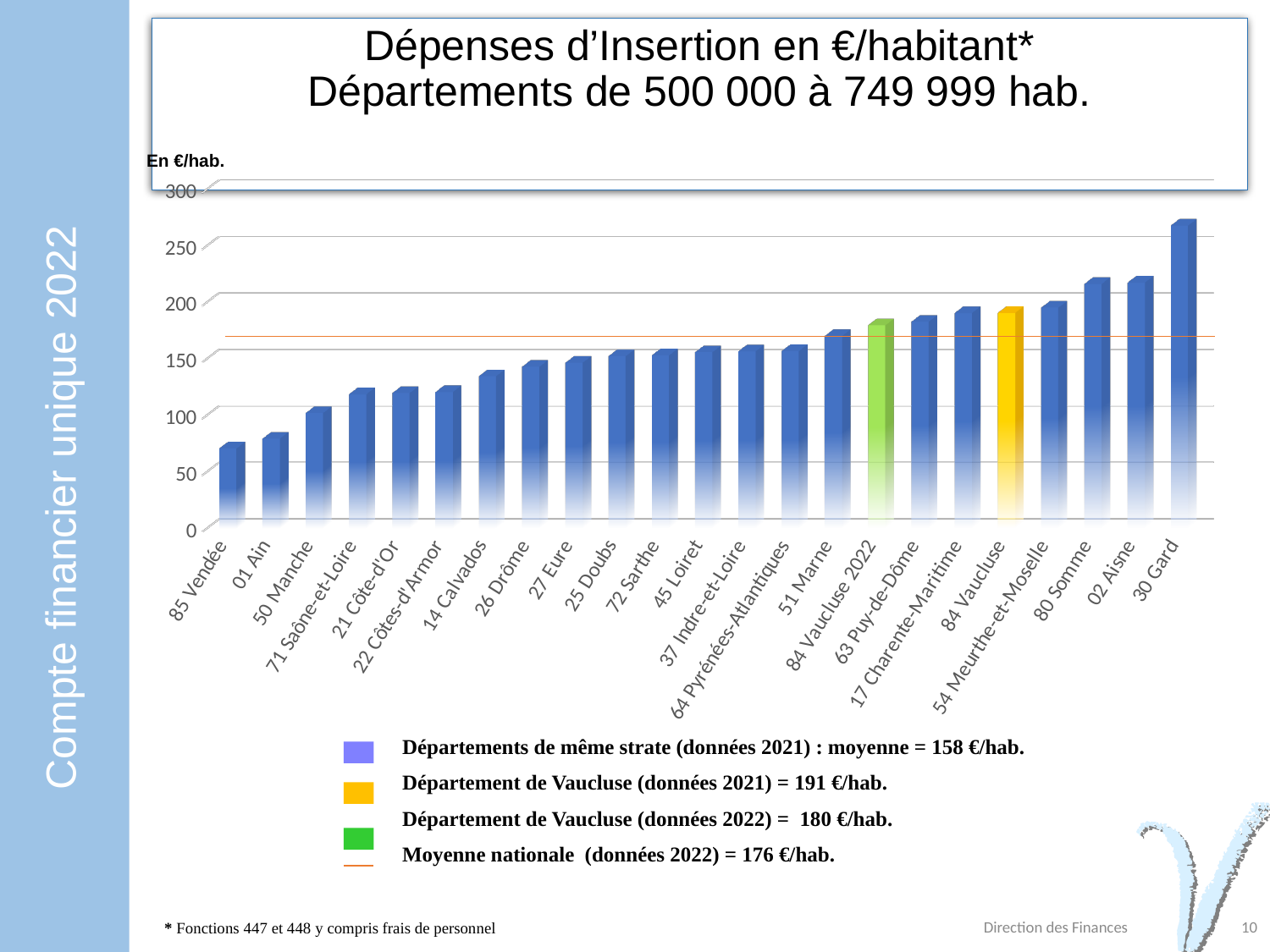
How many departments (bars) are plotted on the chart? 23 What colour is the bar for 84 Vaucluse 2022? green What kind of chart is shown on the slide? bar chart Is the value for 30 Gard greater or less than 250? greater What is the value for Département de Vaucluse (données 2021) according to the legend? 191 €/hab. Which department has the highest insertion spending per inhabitant on the chart? 30 Gard Which is larger, the value for 84 Vaucluse (2021) or for 84 Vaucluse 2022? 84 Vaucluse (2021) Is the value for 85 Vendée greater or less than 100? less What is the difference between the Vaucluse 2021 value and the Vaucluse 2022 value? 11 €/hab. Do the bar values rise or fall from left to right along the x axis? rise Which department has the lowest insertion spending per inhabitant on the chart? 85 Vendée What is the value for Département de Vaucluse (données 2022) according to the legend? 180 €/hab.